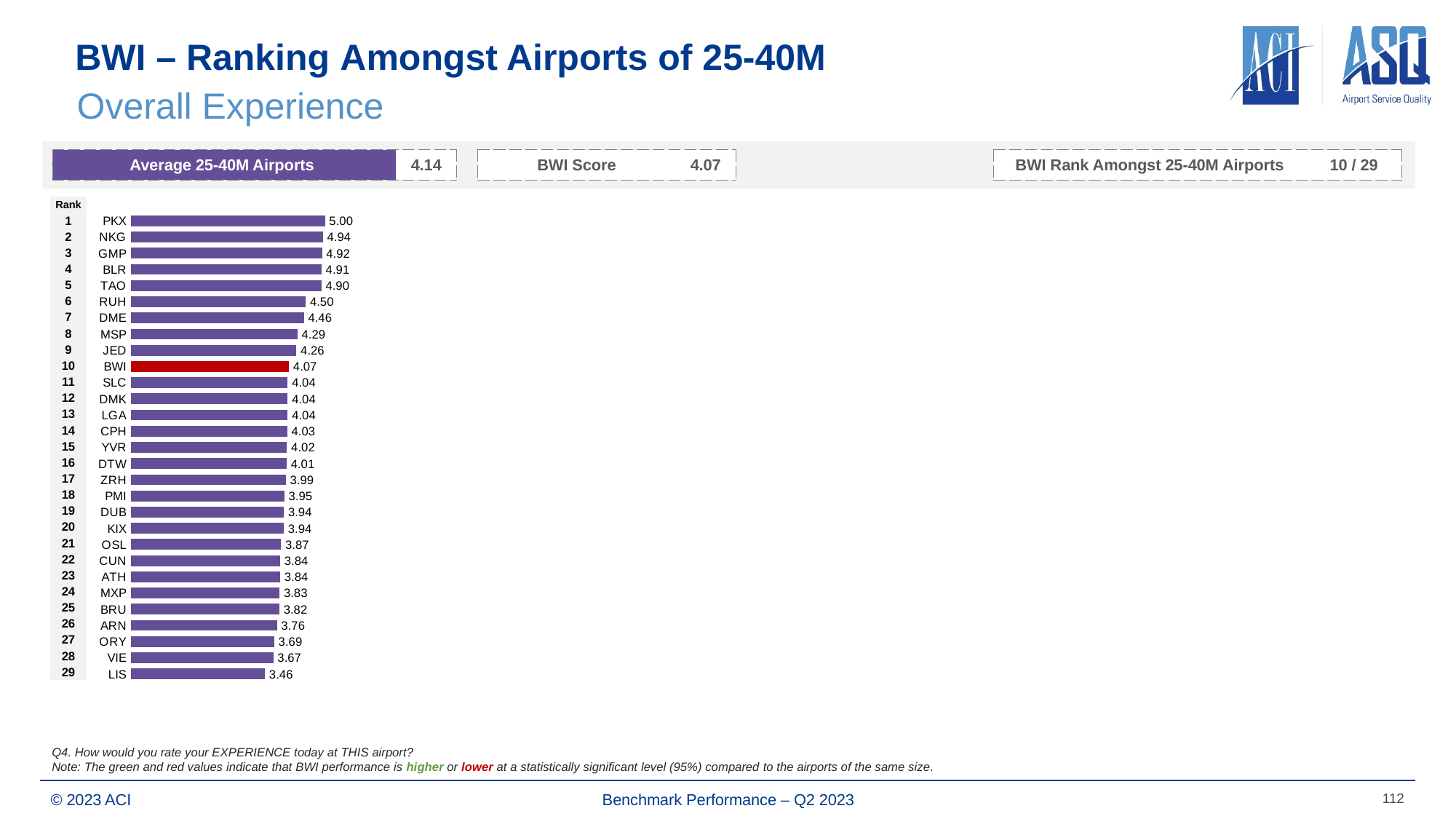
Which has a larger value, ZRH or ARN? ZRH Which airport has the highest value? PKX What kind of chart is shown on the slide? Bar chart What is the value for LIS? 3.46 Which bar in the chart is coloured red? BWI Which airport has the lowest value? LIS What is the difference between the values for PKX and BWI? 0.93 What is the value for BWI? 4.07 How many airports are shown in the chart? 29 What is the difference between the values for BWI and LIS? 0.61 What is the value for PKX? 5.00 Which has a larger value, RUH or MSP? RUH